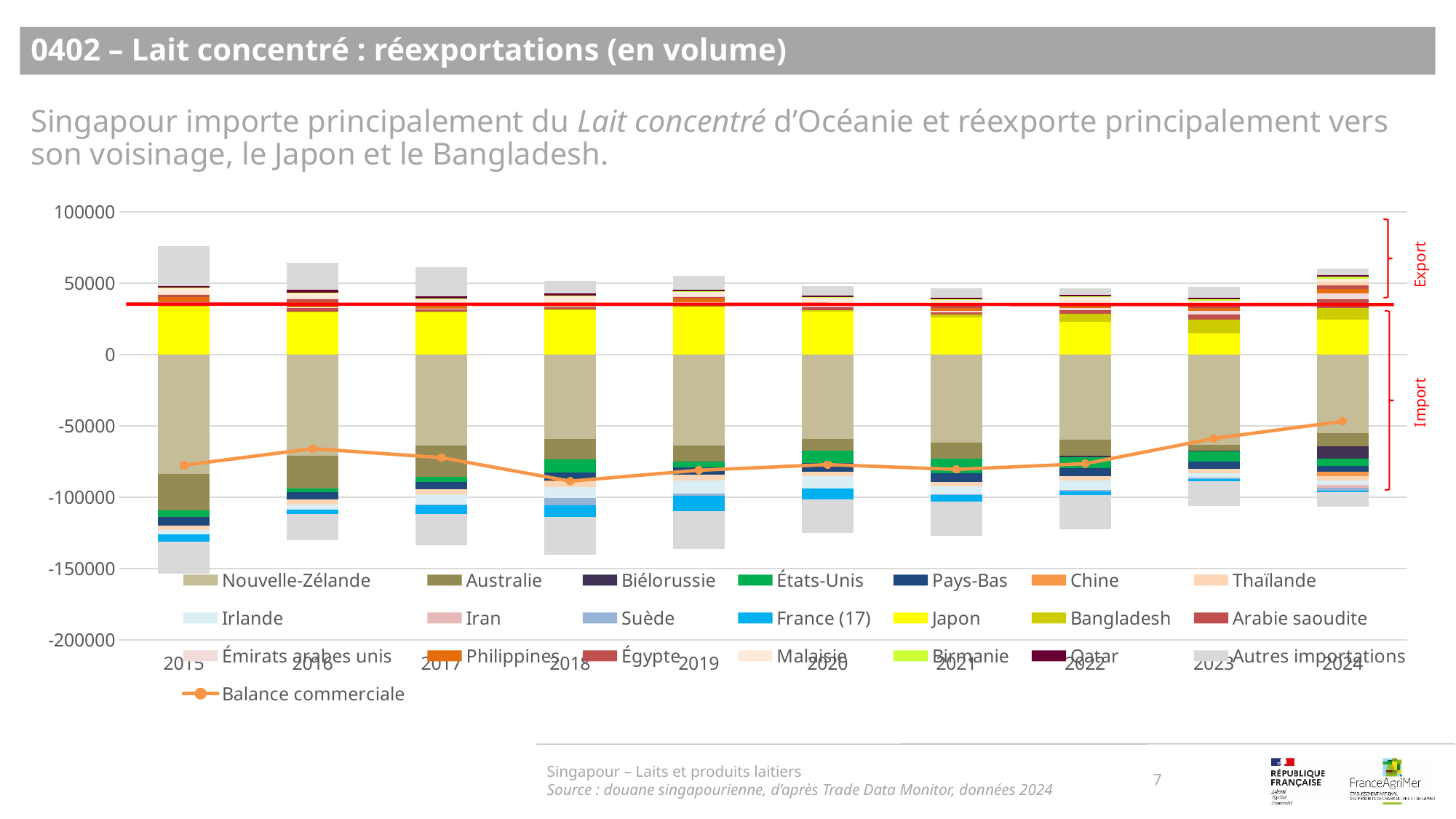
In which year is the Balance commerciale line at its highest point? 2024 Does the Balance commerciale line rise or fall from 2022 to 2024? rise Which colour represents Japon in the chart? yellow What kind of chart is shown on the slide? combination bar and line chart (stacked bars with a line) Which year has the tallest export stack above zero? 2015 What is the title of the slide containing the chart? 0402 – Lait concentré : réexportations (en volume) Is the Balance commerciale value for 2018 greater or less than -50000? less Is the Balance commerciale value for 2024 greater or less than -100000? greater How many years are shown along the x axis of the chart? 10 In which year is the Balance commerciale line at its lowest point? 2018 Is the total export stack (above zero) for 2015 greater or less than 50000? greater How many series does the chart legend list? 22